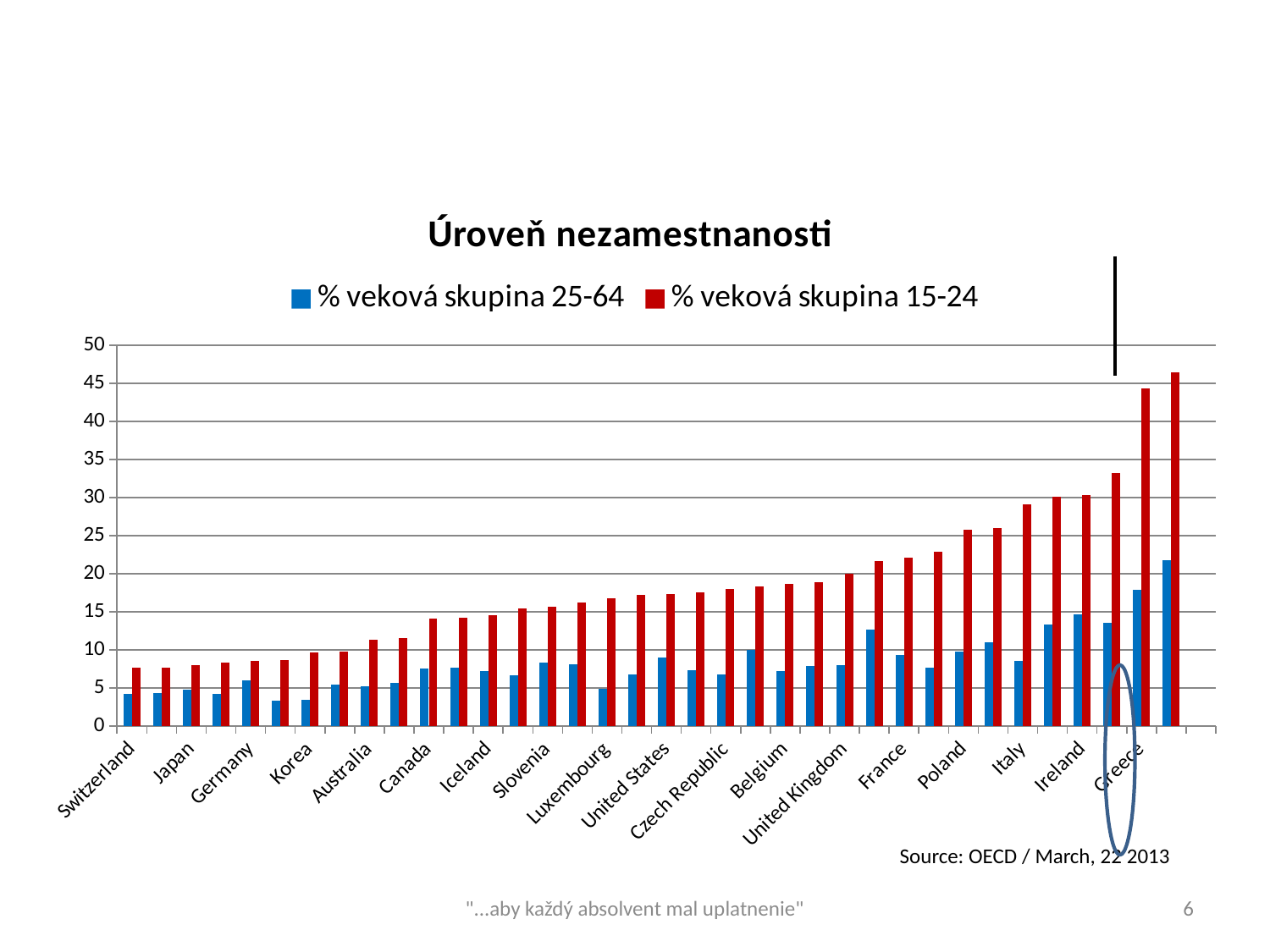
Which is larger for Greece: the % veková skupina 15-24 value or the % veková skupina 25-64 value? % veková skupina 15-24 Is the value for Italy in the % veková skupina 25-64 series greater or less than 10? less How many series does the legend list? 2 What kind of chart is shown on the slide? bar chart Do the values of the % veková skupina 15-24 series rise or fall from left to right along the x axis? rise Is the value for Greece in the % veková skupina 15-24 series greater or less than 30? greater Is the value for Canada in the % veková skupina 15-24 series greater or less than 10? greater Which series is shown in red in the legend? % veková skupina 15-24 What is the title of the chart? Úroveň nezamestnanosti